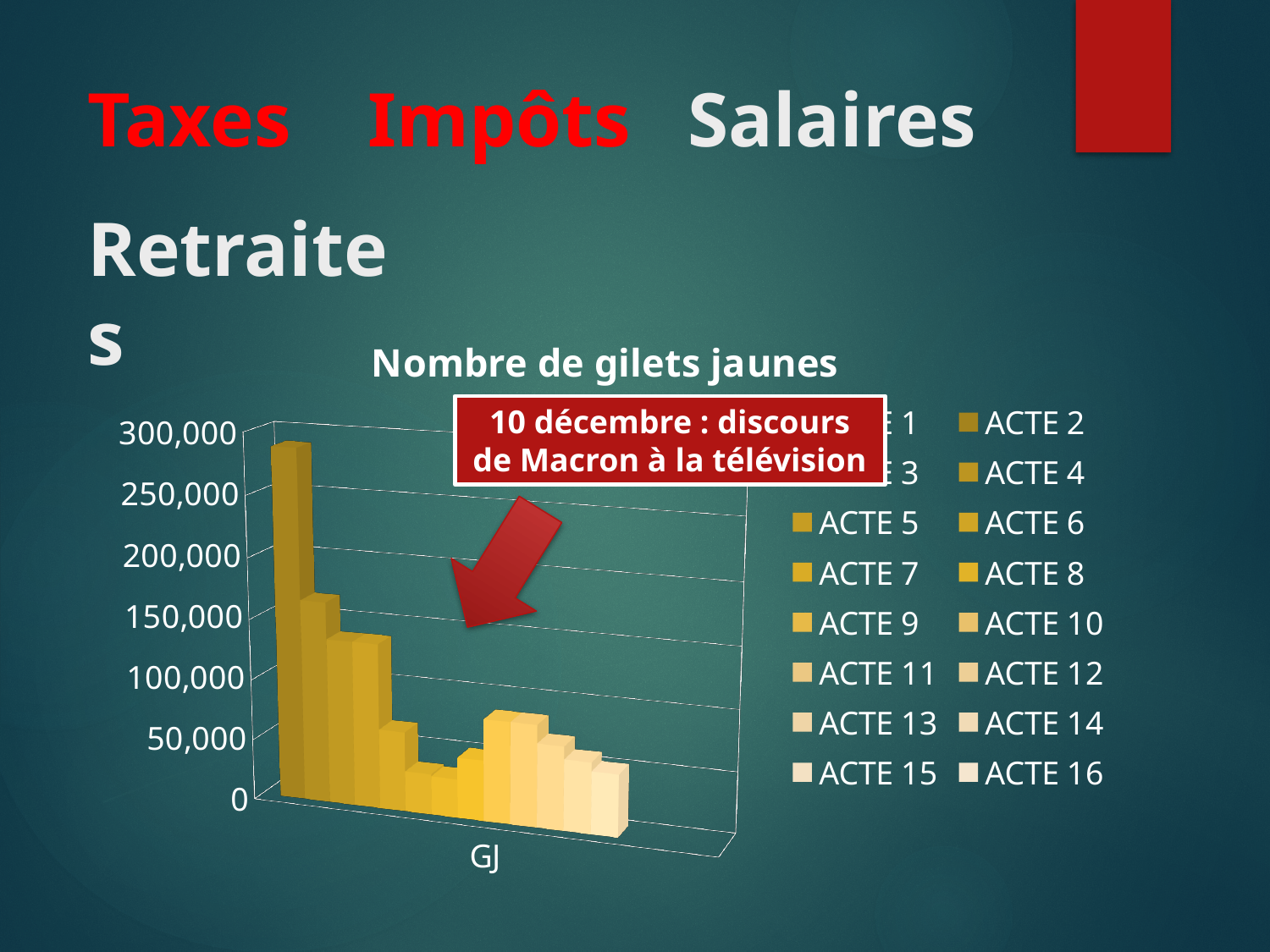
Is the value for ACTE 1 greater or less than 250,000? greater How many categories are shown on the x axis of the chart? 1 Which series has the highest value in the chart? ACTE 1 How many series does the chart legend list? 16 Which is larger, the value for ACTE 1 or the value for ACTE 2? ACTE 1 What type of chart is shown on the slide? Bar chart What does the red annotation box on the chart say? 10 décembre : discours de Macron à la télévision What is the title of the chart? Nombre de gilets jaunes Is the value for ACTE 1 greater or less than 300,000? less Is the value for ACTE 3 greater or less than 200,000? less What is the label of the category on the x axis? GJ